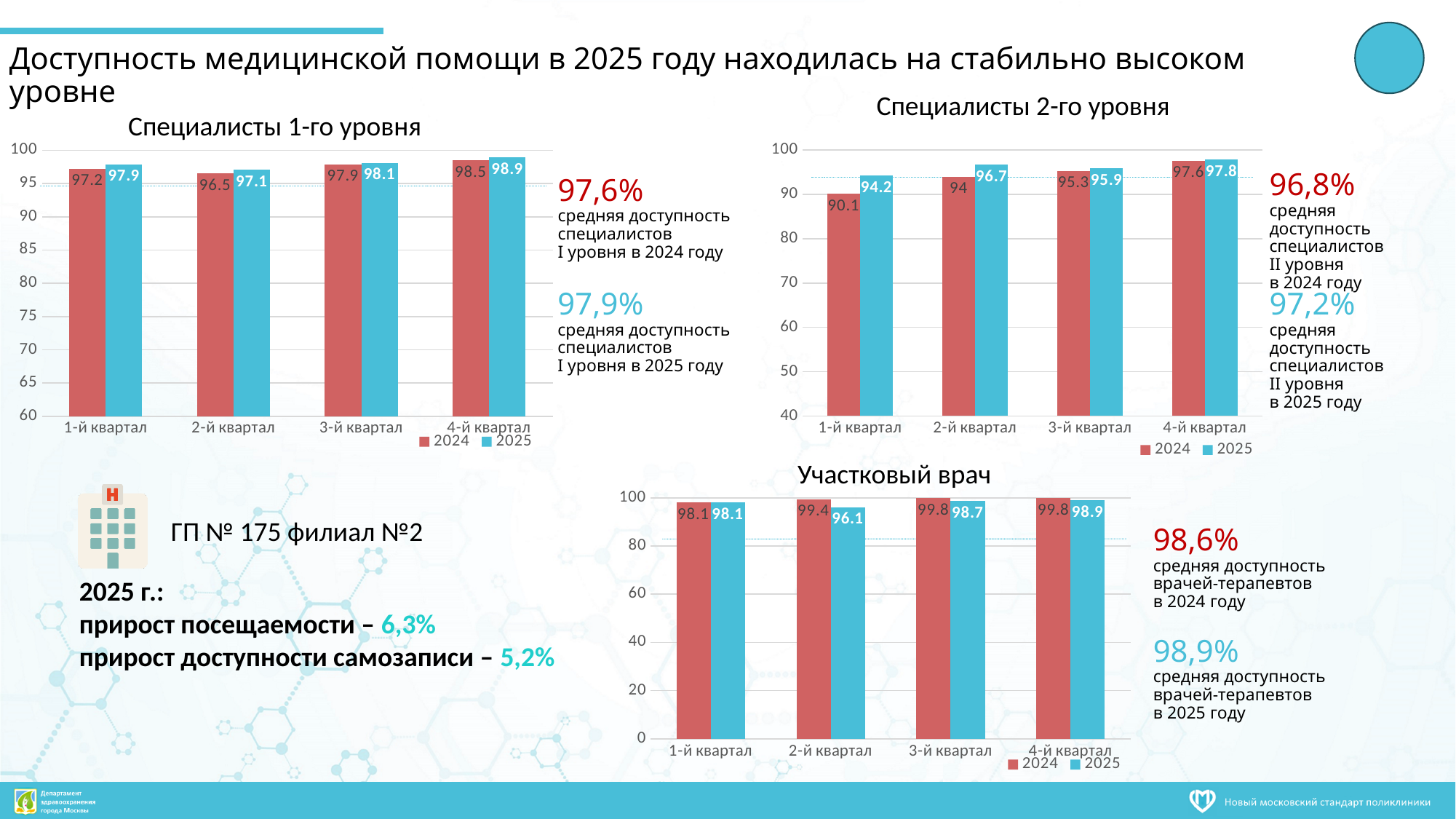
What kind of chart is 'Специалисты 2-го уровня'? Bar chart In the chart 'Специалисты 2-го уровня', do the 2024 values rise or fall from 1-й квартал to 4-й квартал? Rise How many quarters are shown on the x axis of the chart 'Участковый врач'? 4 How many series does the legend list in the chart 'Специалисты 1-го уровня'? 2 In the chart 'Специалисты 1-го уровня', what is the value for 2024 in 2-й квартал? 96.5 In the chart 'Участковый врач', what is the value for 2025 in 2-й квартал? 96.1 In the chart 'Участковый врач', which quarter has the lowest value for 2025? 2-й квартал In the chart 'Специалисты 1-го уровня', what is the value for 2025 in 4-й квартал? 98.9 In the chart 'Специалисты 2-го уровня', what is the value for 2024 in 1-й квартал? 90.1 In the chart 'Специалисты 2-го уровня', which quarter has the lowest value for 2024? 1-й квартал In the chart 'Участковый врач', which is larger in 2-й квартал: the 2024 value or the 2025 value? 2024 In the chart 'Специалисты 2-го уровня', what is the difference between the 2025 and 2024 values in 1-й квартал? 4.1